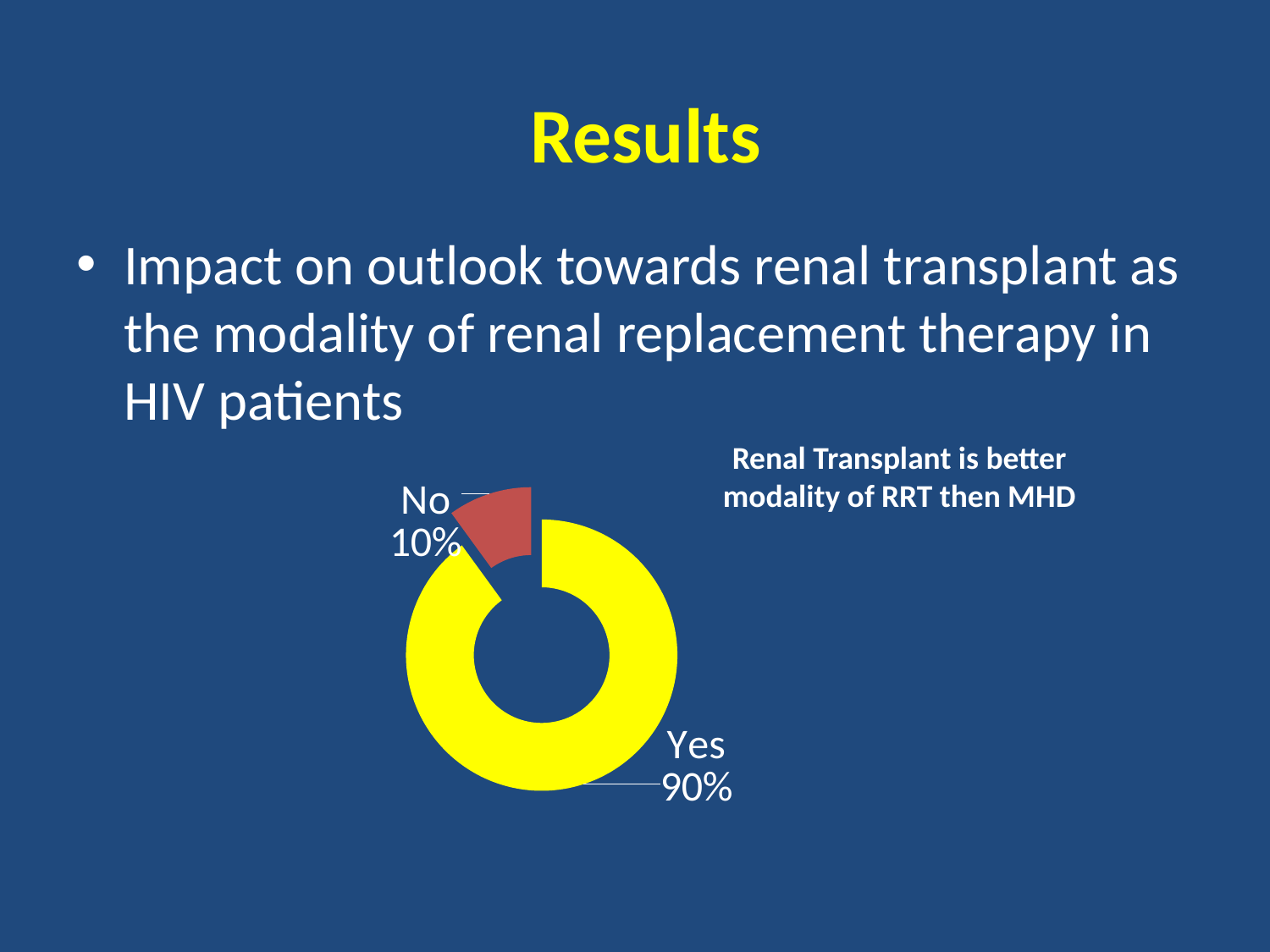
What colour is the "Yes" slice of the pie chart? Yellow How many categories are shown in the pie chart? 2 Which category has the largest share of the pie chart? Yes What is the difference in percentage points between the "Yes" and "No" slices? 80 What kind of chart is shown on the slide? Pie chart (doughnut) Which slice is larger, "Yes" or "No"? Yes What percentage of the pie chart is labelled "No"? 10% What percentage of the pie chart is labelled "Yes"? 90% What is the title of the chart? Renal Transplant is better modality of RRT then MHD Which category has the smallest share of the pie chart? No What share of the pie does the "No" slice represent? 10%